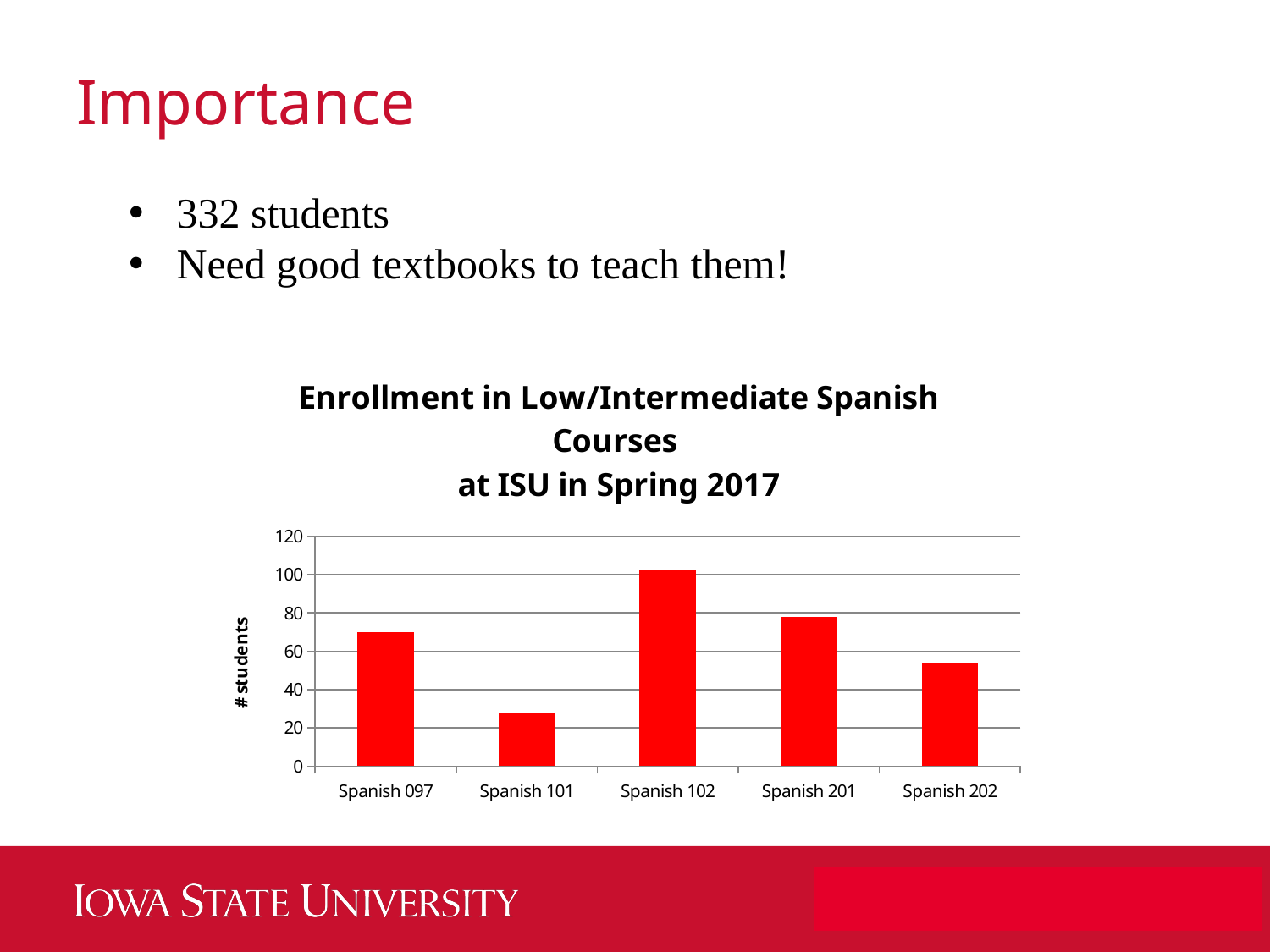
Which has the larger enrollment, Spanish 201 or Spanish 101? Spanish 201 What is the label on the vertical axis of the chart? # students How many courses are shown on the x axis of the chart? 5 Is the value for Spanish 101 greater or less than 40? less Which course has the lowest enrollment in the chart? Spanish 101 Which course has the highest enrollment in the chart? Spanish 102 Is the value for Spanish 097 greater or less than 60? greater What kind of chart is shown on the slide? bar chart Which has the larger enrollment, Spanish 097 or Spanish 202? Spanish 097 Is the value for Spanish 202 greater or less than 60? less